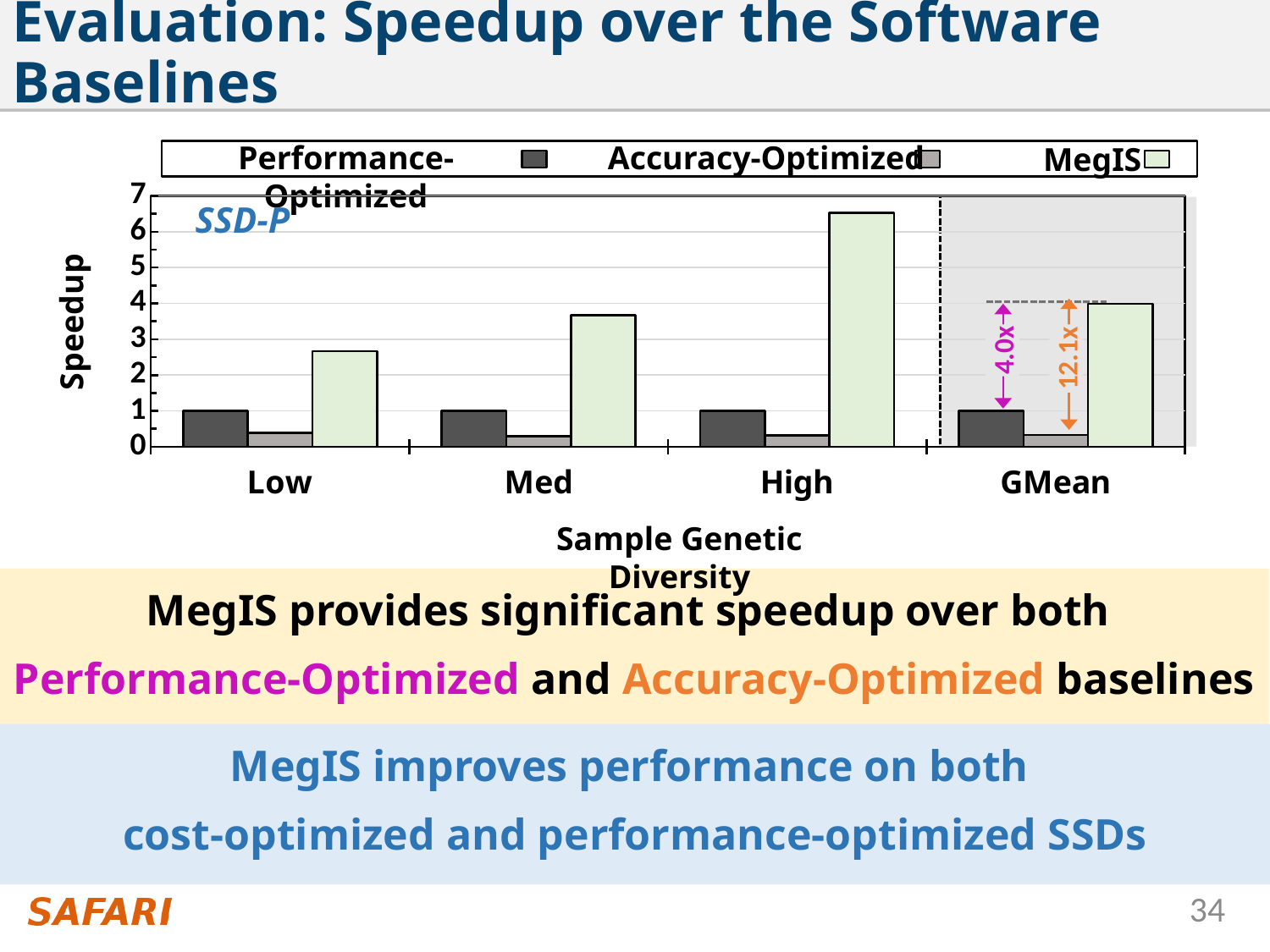
What kind of chart is shown on the slide? bar chart How many series does the legend list? 3 What speedup of MegIS over Performance-Optimized is annotated at GMean? 4.0x What speedup of MegIS over Accuracy-Optimized is annotated at GMean? 12.1x For which category is the MegIS bar the highest? High Is the MegIS value for Low greater or less than 3? less For which category is the MegIS bar the lowest? Low For the Med category, which is larger: the MegIS bar or the Accuracy-Optimized bar? MegIS Is the MegIS value for High greater or less than 6? greater What is the label of the y axis? Speedup Do the MegIS bars rise or fall going from Low to Med to High? rise How many categories are shown on the x axis? 4